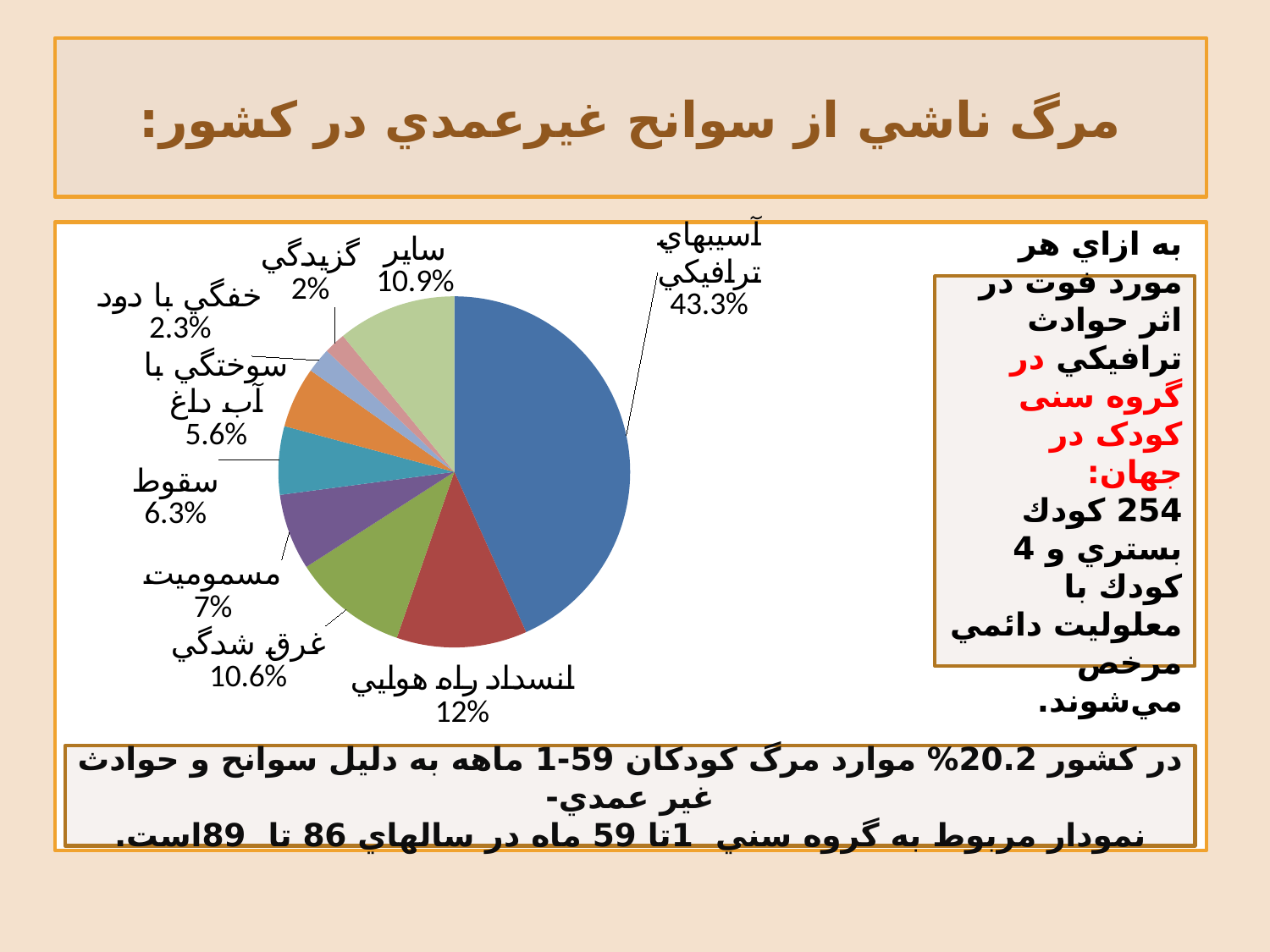
What percentage is shown for خفگي با دود? 2.3% How many slices does the pie chart have? 9 Which category has the largest share of the pie? آسيبهاي ترافيكي Which category has the smallest share of the pie? گزيدگي What percentage is shown for غرق شدگي? 10.6% What is the difference between the shares of سايرر and غرق شدگي? 0.3% What percentage of the pie is labelled آسيبهاي ترافيكي? 43.3% What percentage is shown for انسداد راه هوايي? 12% What is the difference between the shares of آسيبهاي ترافيكي and انسداد راه هوايي? 31.3% Which is larger, the share for مسموميت or the share for سقوط? مسموميت What kind of chart is shown on the slide? pie chart What percentage is shown for سقوط? 6.3%